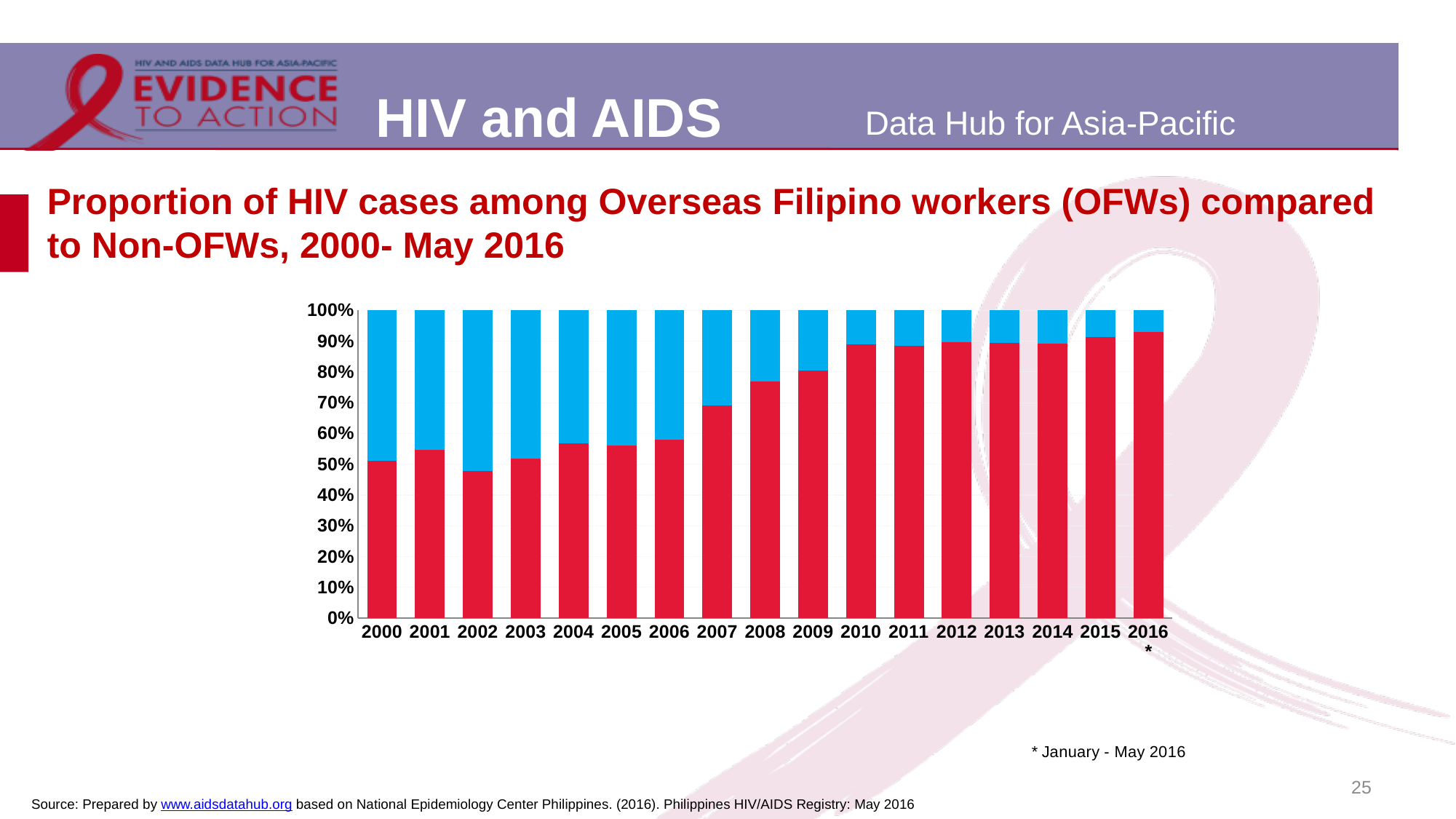
According to the footnote, what period does the 2016 bar cover? January - May 2016 Is the red segment for 2002 greater or less than 50%? less Which year has a larger red segment, 2004 or 2007? 2007 Is the red segment for 2010 greater or less than 80%? greater What is the total height of each stacked bar in the chart? 100% Which year has the smallest red segment? 2002 Is the red segment for 2004 greater or less than 50%? greater What kind of chart is shown on the slide? Stacked bar chart Does the red segment generally rise or fall from 2000 to 2016? Rise How many years are shown along the x axis of the chart? 17